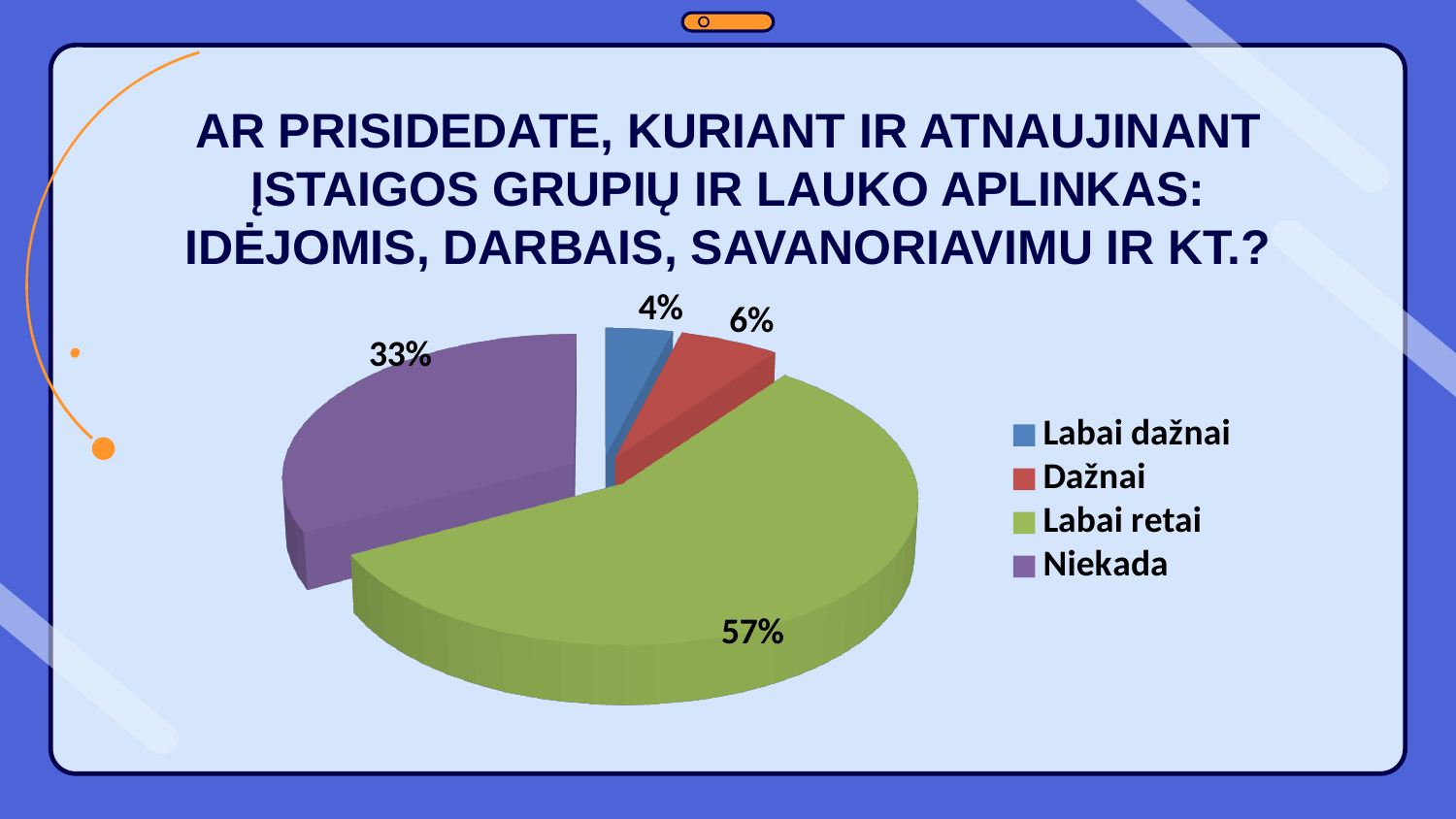
What is the difference in percentage points between "Labai retai" and "Niekada"? 24 What share of the pie does "Labai dažnai" have? 4% What colour is the slice for "Niekada"? purple What share of the pie does "Niekada" have? 33% What share of the pie does "Dažnai" have? 6% Which is larger, the slice for "Dažnai" or the slice for "Labai dažnai"? Dažnai How many categories does the pie chart have? 4 Which category has the smallest slice of the pie? Labai dažnai Which legend entry is listed third? Labai retai Which category has the largest slice of the pie? Labai retai What kind of chart is shown on the slide? pie chart